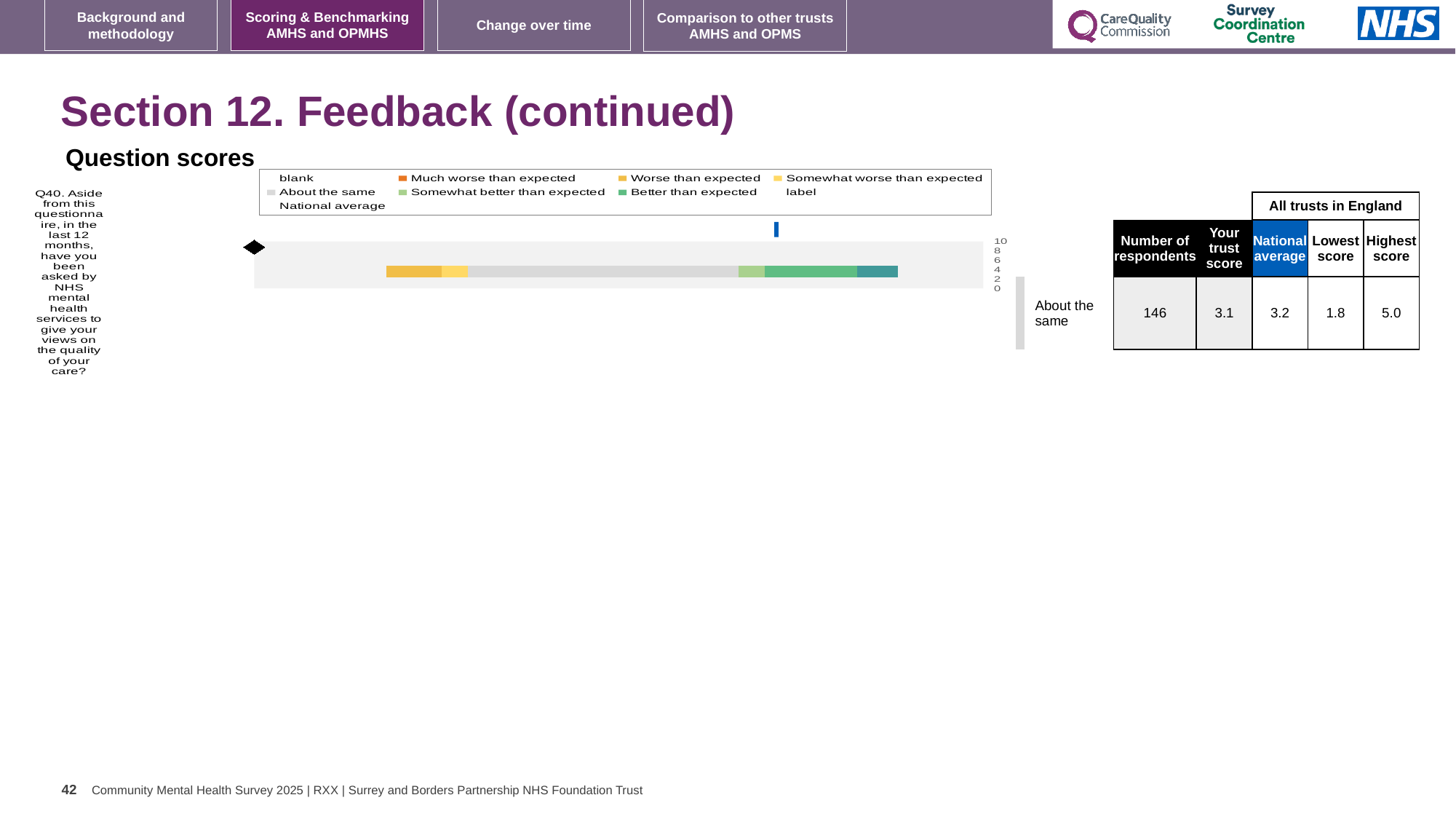
Which question is plotted in the Question scores chart? Q40 In the table next to the chart, what is the lowest score across all trusts in England for Q40? 1.8 In the table next to the chart, what is the difference between the highest score and the lowest score for Q40? 3.2 In the table next to the chart, what is the national average for Q40? 3.2 Which category label is shown to the right of the bar for Q40? About the same In the table next to the chart, what is the highest score across all trusts in England for Q40? 5.0 What colour does the chart legend use for 'Much worse than expected'? orange In the table next to the chart, what is the number of respondents for Q40? 146 What kind of chart is shown under 'Question scores'? bar chart In the table next to the chart, which is larger for Q40: your trust score or the national average? national average How many questions are plotted in the Question scores chart? 1 In the table next to the chart, what is your trust score for Q40? 3.1